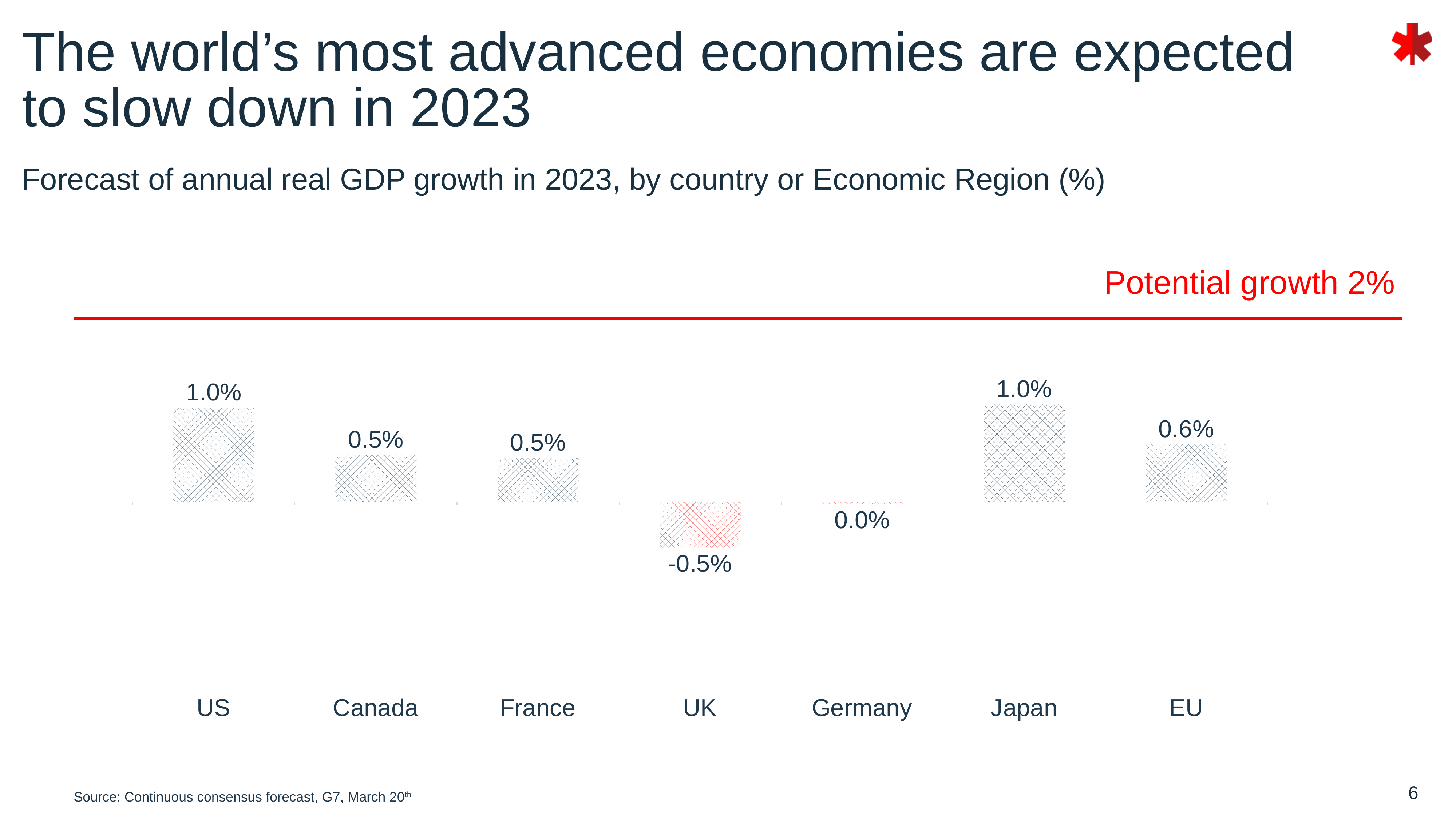
How many countries or regions are shown in the chart? 7 What is the difference between the forecast GDP growth for Japan and the UK? 1.5% What is the forecast GDP growth for the US? 1.0% What is the forecast GDP growth for the EU? 0.6% Which bar is shown in red rather than grey? UK Which country or region has the lowest forecast GDP growth? UK What is the forecast GDP growth for the UK? -0.5% What is the forecast GDP growth for Germany? 0.0% Which has a higher forecast GDP growth, the EU or France? EU What potential growth rate is marked by the red line? 2% What is the difference between the forecast GDP growth for the US and Canada? 0.5% What kind of chart is shown on the slide? Bar chart